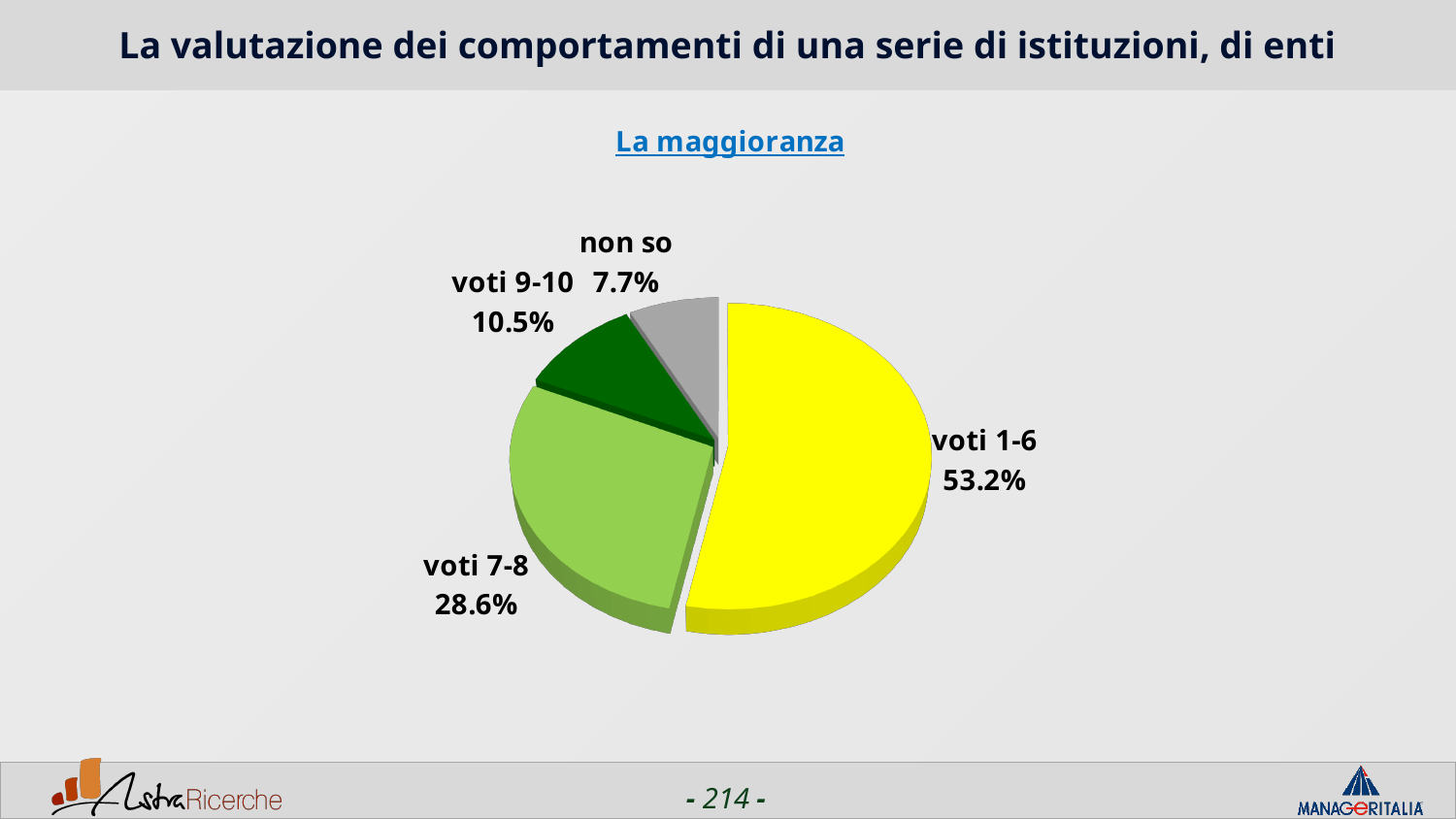
What percentage is shown for 'non so'? 7.7% What percentage is shown for 'voti 1-6'? 53.2% How many slices does the pie chart have? 4 What kind of chart is shown on the slide? pie chart What percentage is shown for 'voti 9-10'? 10.5% What percentage is shown for 'voti 7-8'? 28.6% Which slice of the pie is the largest? voti 1-6 What is the difference in percentage points between 'voti 1-6' and 'voti 7-8'? 24.6 Which is larger, 'voti 9-10' or 'non so'? voti 9-10 What is the subtitle shown above the pie chart? La maggioranza Which slice of the pie is the smallest? non so What colour is the 'voti 1-6' slice? yellow